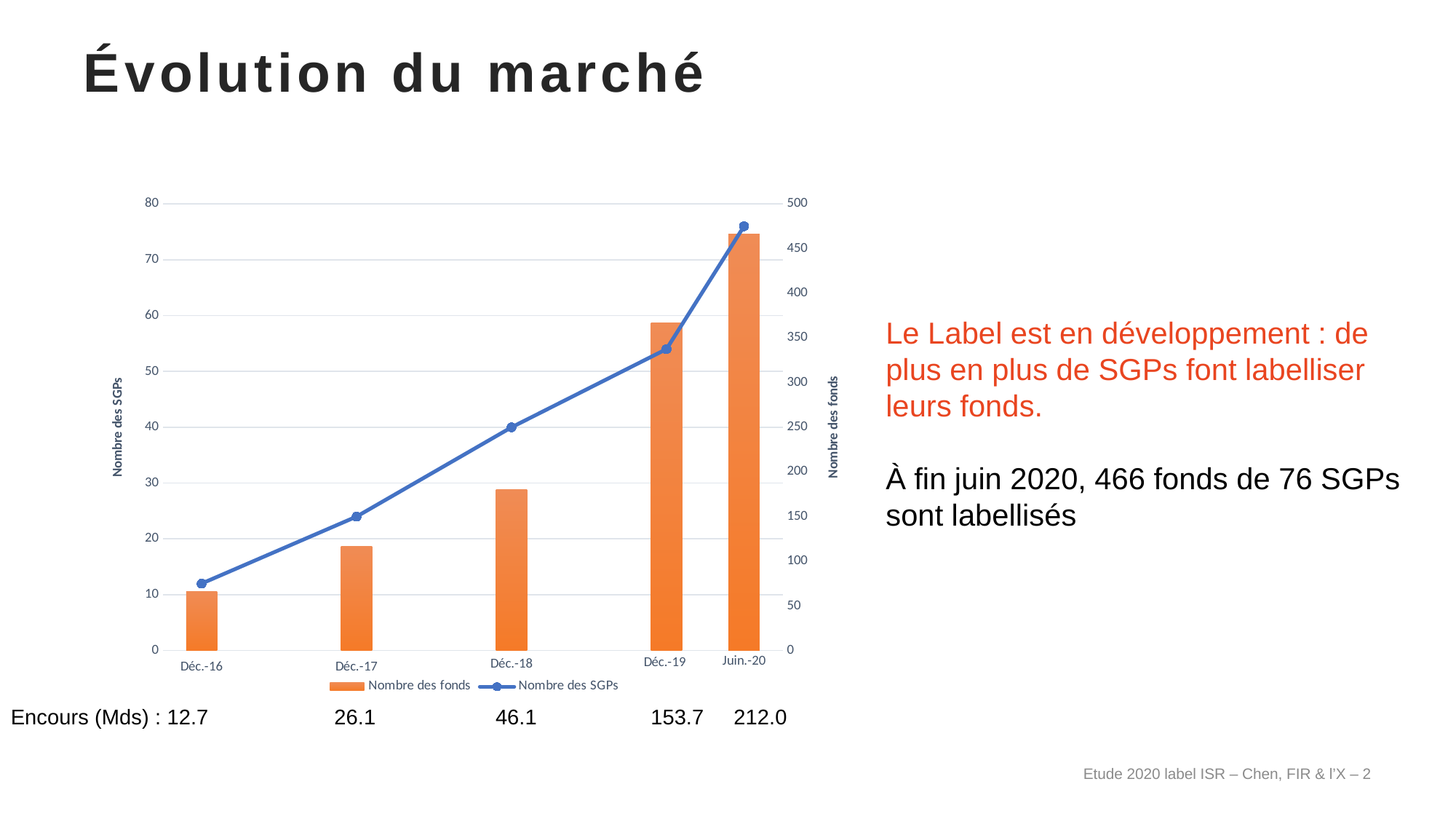
Do the Nombre des SGPs values rise or fall from Déc.-16 to Juin.-20? Rise Is the Nombre des fonds value for Déc.-19 greater or less than 300? greater Which period has the larger Nombre des SGPs value, Déc.-17 or Déc.-19? Déc.-19 What is the title of the left vertical axis? Nombre des SGPs Is the Nombre des SGPs value for Déc.-17 greater or less than 30? less How many time periods are shown on the x axis of the chart? 5 Is the Nombre des SGPs value for Juin.-20 greater or less than 70? greater Which series are listed in the chart legend? Nombre des fonds and Nombre des SGPs In which period is the Nombre des fonds bar the highest? Juin.-20 What kind of chart is shown on the slide? A bar chart combined with a line chart In which period is the Nombre des fonds bar the lowest? Déc.-16 How many series does the chart legend list? 2